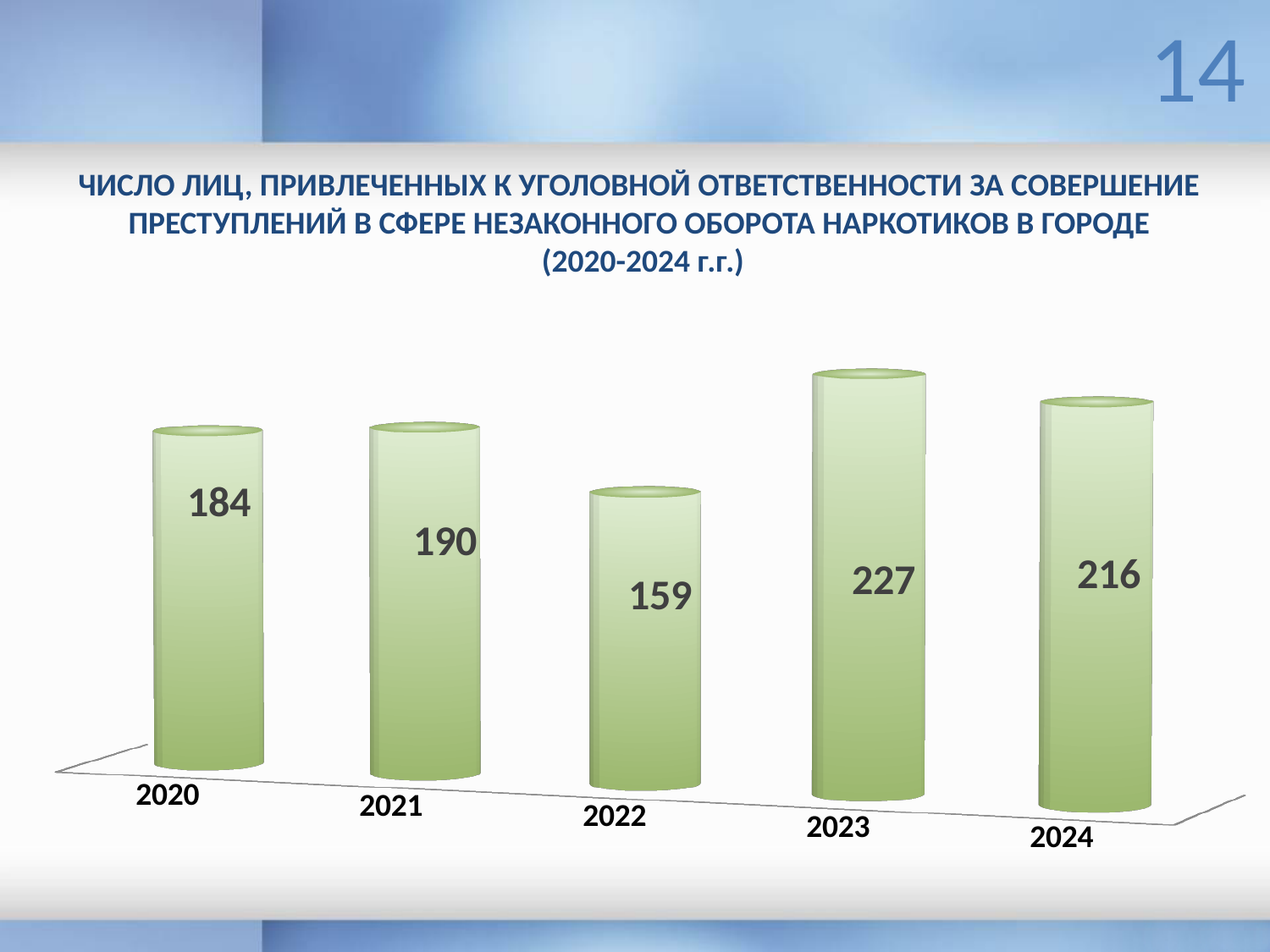
What is the value for 2024? 216 Which year has the highest value? 2023 Does the value rise or fall from 2023 to 2024? Fall What kind of chart is shown on the slide? Bar chart Which year has the lowest value? 2022 What is the value for 2022? 159 How many years are shown on the chart? 5 Which is larger, the value for 2024 or the value for 2021? 2024 What years does the chart title say the data covers? 2020-2024 What is the difference between the values for 2021 and 2020? 6 What is the difference between the values for 2023 and 2022? 68 What is the value for 2020? 184